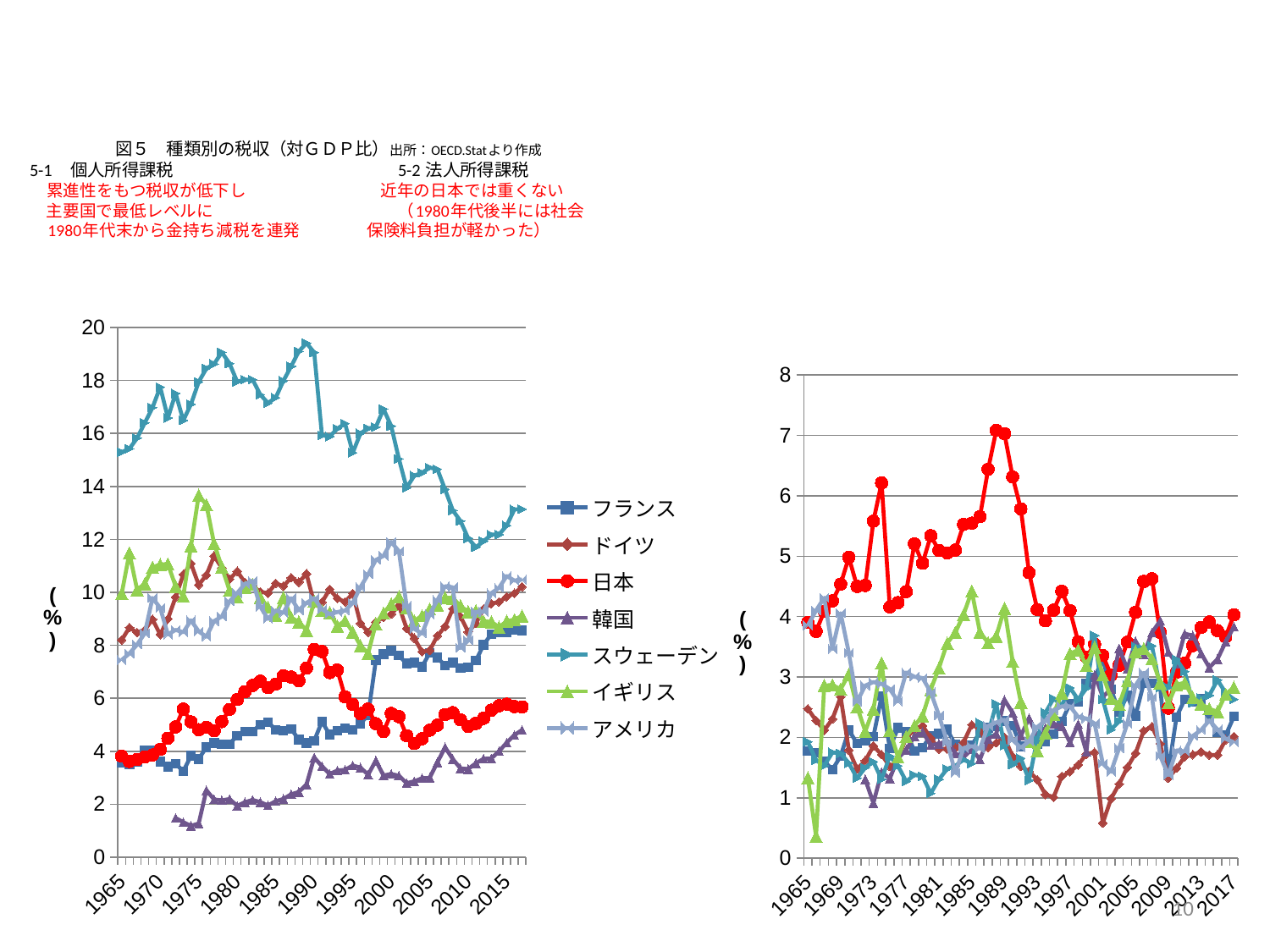
In the right chart (5-2 法人所得課税), does the value for 日本 rise or fall between 1989 and 1993? fall What kind of chart is the left chart (5-1 個人所得課税)? line chart In the left chart (5-1 個人所得課税), which country has the highest value in 1990? スウェーデン In the left chart (5-1 個人所得課税), which is larger in 2015, the value for スウェーデン or the value for 日本? スウェーデン In the right chart (5-2 法人所得課税), is the value for 日本 in 1989 greater or less than 6? greater In the right chart (5-2 法人所得課税), which country has the highest value in 1989? 日本 In the left chart (5-1 個人所得課税), which country has the lowest value in 1975? 韓国 In the left chart (5-1 個人所得課税), is the value for 韓国 in 1975 greater or less than 2? less In the left chart (5-1 個人所得課税), does the value for スウェーデン rise or fall between 1990 and 2010? fall In the left chart (5-1 個人所得課税), is the value for スウェーデン in 1990 greater or less than 18? greater How many series does the legend list for the charts? 7